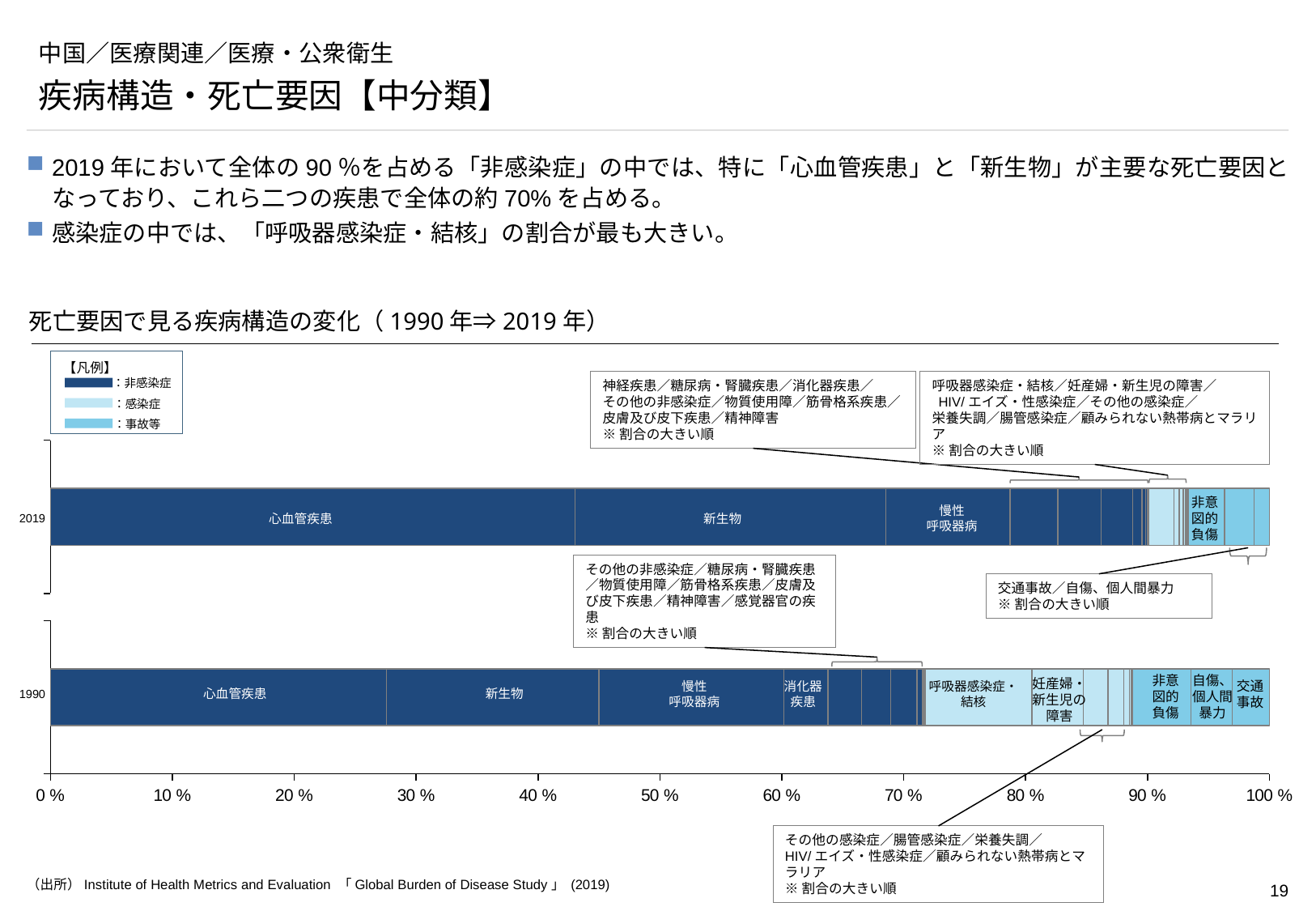
What kind of chart is shown on the slide? stacked bar chart According to the legend, which category is shown in dark blue? 非感染症 Is the share of 心血管疾患 in 1990 greater or less than 30%? less What is the title of the chart? 死亡要因で見る疾病構造の変化（1990年⇒2019年） How many years (bars) does the chart compare? 2 Which cause of death has the largest share in the 2019 bar? 心血管疾患 Is the share of 新生物 larger in 2019 or in 1990? 2019 Is the share of 心血管疾患 larger in 2019 or in 1990? 2019 Which cause of death has the largest share in the 1990 bar? 心血管疾患 How many categories does the legend (凡例) list? 3 In the 2019 bar, which is larger: 新生物 or 慢性呼吸器病? 新生物 Is the share of 心血管疾患 in 2019 greater or less than 40%? greater